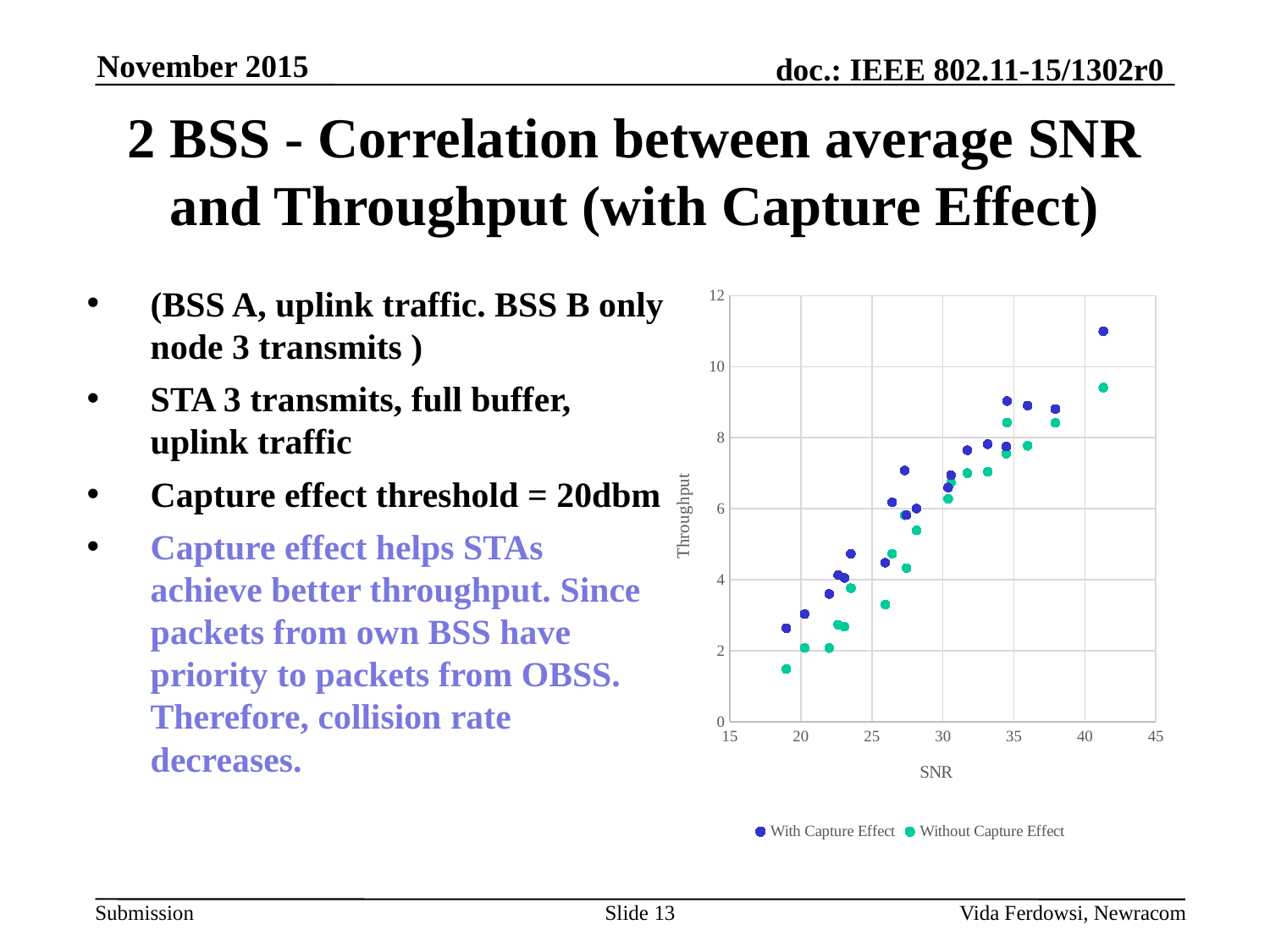
At the highest SNR plotted (around 41), which series has the higher throughput? With Capture Effect Is the lowest throughput value for the Without Capture Effect series greater or less than 2? less What are the two series named in the chart's legend? With Capture Effect and Without Capture Effect What are the titles of the x axis and y axis of the chart? SNR (x axis) and Throughput (y axis) Does the With Capture Effect series generally lie above or below the Without Capture Effect series? Above How many series does the chart's legend list? 2 Which series contains the point with the highest throughput on the chart? With Capture Effect Is the lowest throughput value for the With Capture Effect series greater or less than 4? less Is the highest throughput value for the With Capture Effect series greater or less than 10? greater What kind of chart is shown on the slide? Scatter chart As SNR increases along the x axis, does throughput rise or fall? Rise